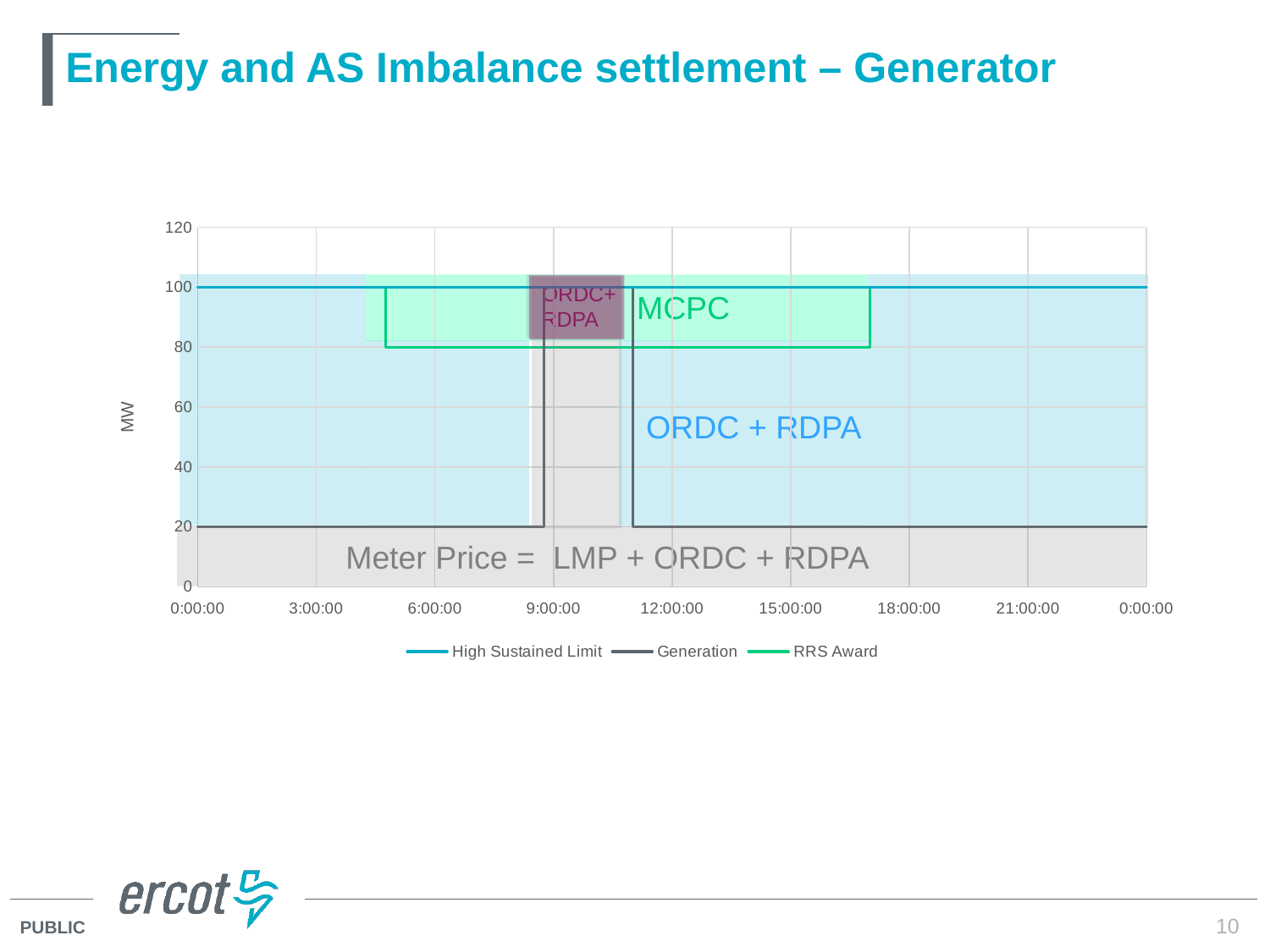
What is the value of the Generation series at 3:00:00 in MW? 20 Which series has the lowest value at 3:00:00? Generation How many series does the chart legend list? 3 What is the value of the High Sustained Limit series in MW? 100 What is the difference in MW between the High Sustained Limit and the RRS Award at 12:00:00? 20 What kind of chart is shown on the slide? line chart Is the Generation value at 6:00:00 greater or less than 40? less What is the value of the RRS Award series at 12:00:00 in MW? 80 What is the maximum value shown on the vertical axis? 120 Which series has the highest value at 15:00:00? High Sustained Limit Which is larger at 15:00:00, the RRS Award or the Generation value? RRS Award What label is shown on the vertical axis of the chart? MW